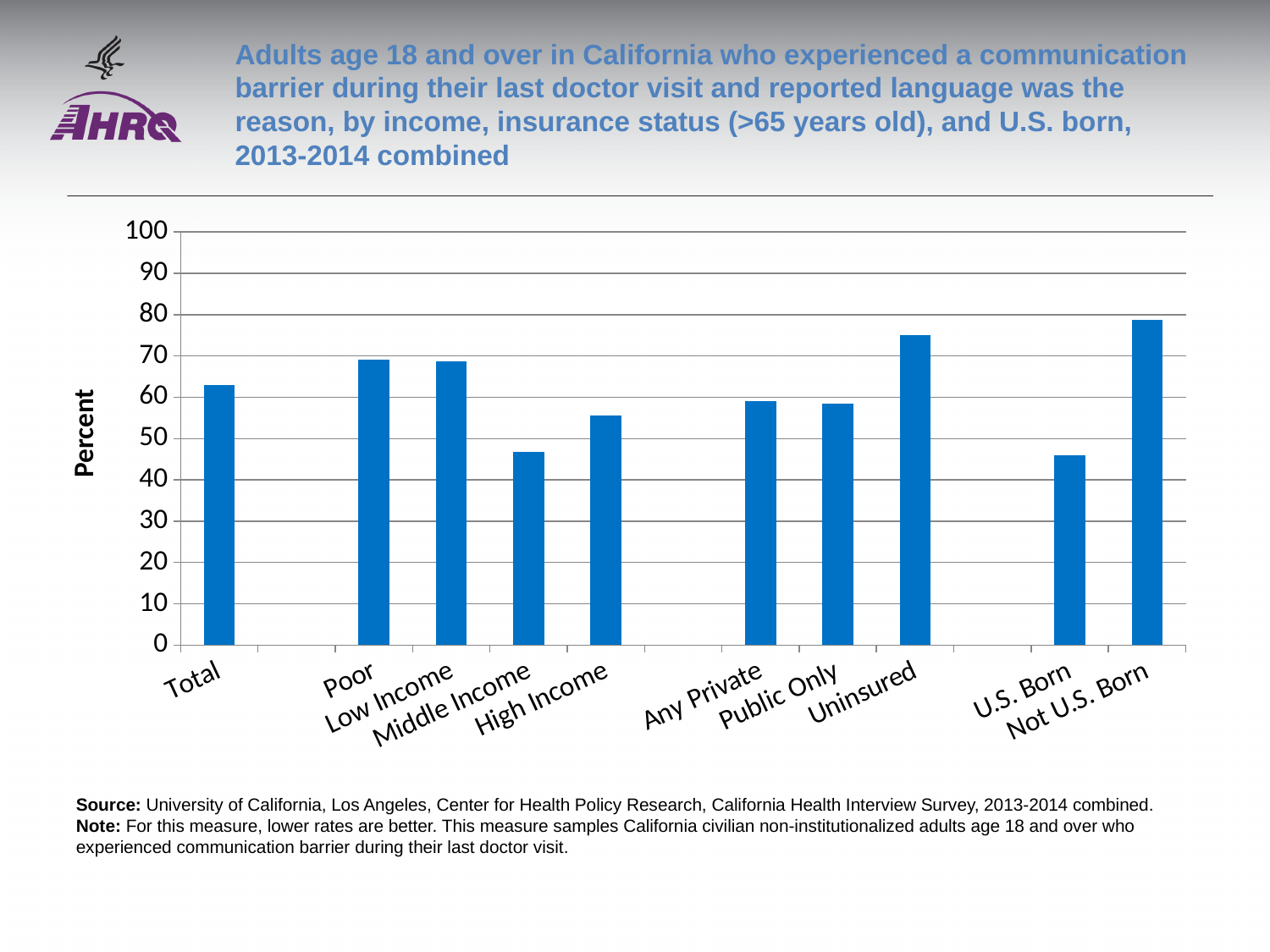
How many categories are plotted on the chart? 10 Is the value for Poor greater or less than 60? greater Which is larger, the value for Middle Income or the value for High Income? High Income What is the label on the vertical axis of the chart? Percent Is the value for Total greater or less than 60? greater Is the value for Uninsured greater or less than 70? greater What kind of chart is shown on the slide? bar chart Which category has the highest value on the chart? Not U.S. Born Which is larger, the value for Uninsured or the value for Any Private? Uninsured